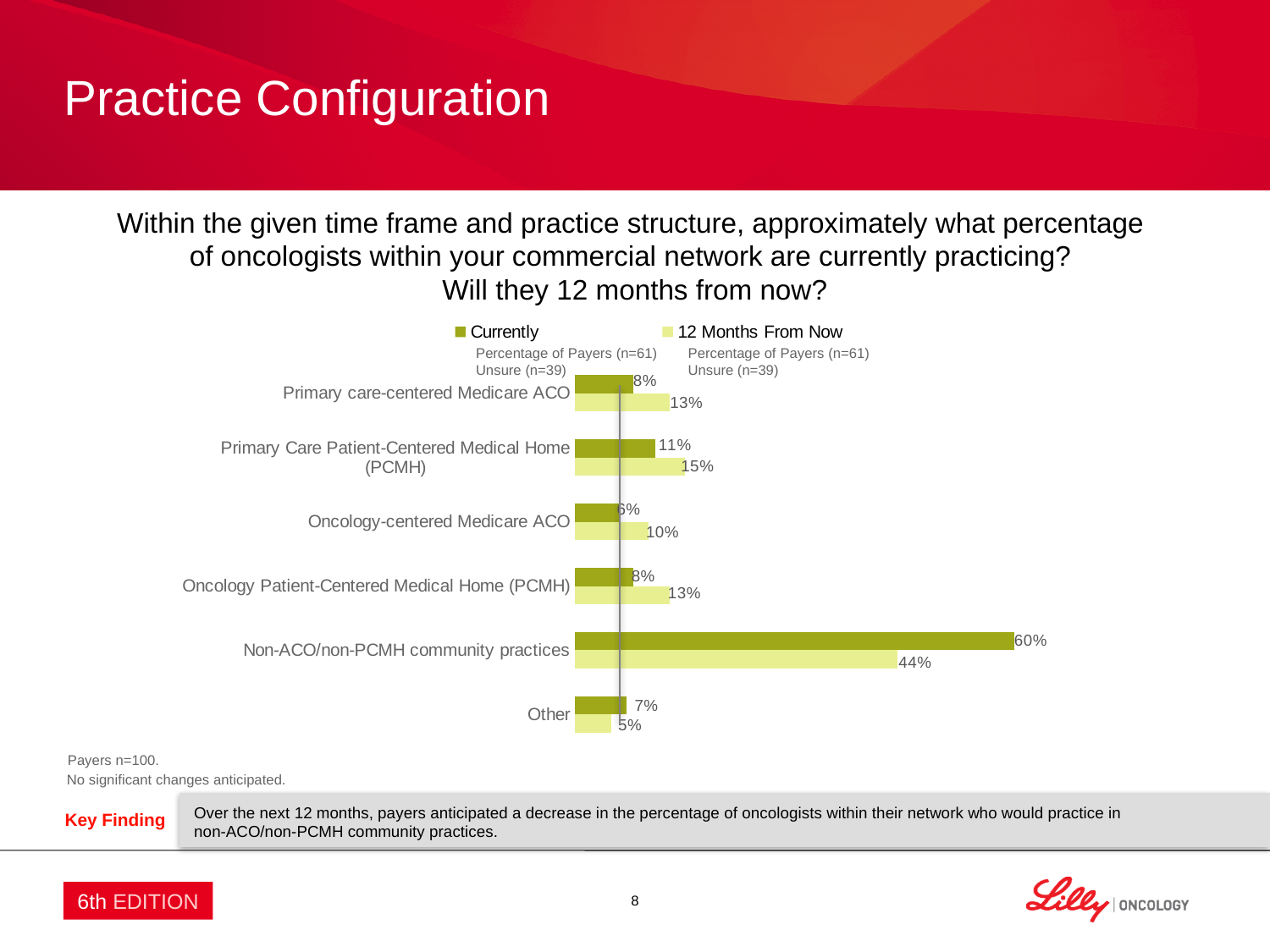
What is the difference between the 'Currently' and '12 Months From Now' values for Non-ACO/non-PCMH community practices? 16% For Oncology-centered Medicare ACO, which is larger: the 'Currently' value or the '12 Months From Now' value? 12 Months From Now Which category has the lowest '12 Months From Now' value? Other How many practice configuration categories are shown in the chart? 6 What is the '12 Months From Now' value for Non-ACO/non-PCMH community practices? 44% What is the 'Currently' value for Non-ACO/non-PCMH community practices? 60% What is the '12 Months From Now' value for Primary Care Patient-Centered Medical Home (PCMH)? 15% What is the 'Currently' value for Other? 7% How many series does the legend list? 2 What is the 'Currently' value for Oncology-centered Medicare ACO? 6% Which category has the highest 'Currently' value? Non-ACO/non-PCMH community practices What type of chart is shown on the slide? Bar chart